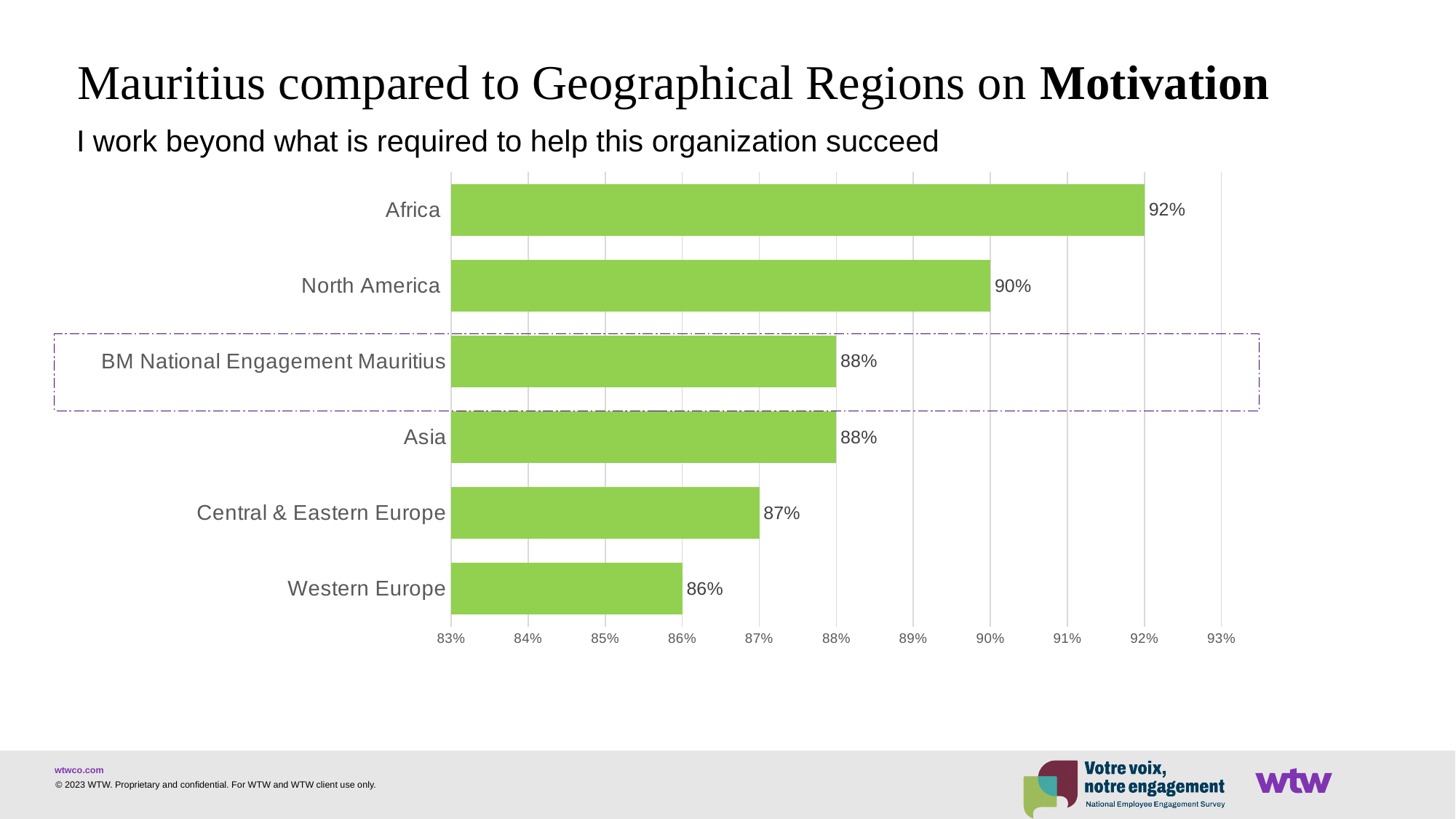
What is the difference between the values for North America and BM National Engagement Mauritius? 2% Which region has the lowest value? Western Europe What kind of chart is shown on the slide? Bar chart What is the value for Western Europe? 86% What is the survey statement shown as the chart subtitle? I work beyond what is required to help this organization succeed What is the difference between the values for Africa and Western Europe? 6% What is the value for Central & Eastern Europe? 87% Which is larger, the value for North America or the value for Asia? North America What is the value for BM National Engagement Mauritius? 88% What is the value for Africa? 92% Which region has the highest value? Africa How many categories are shown in the chart? 6